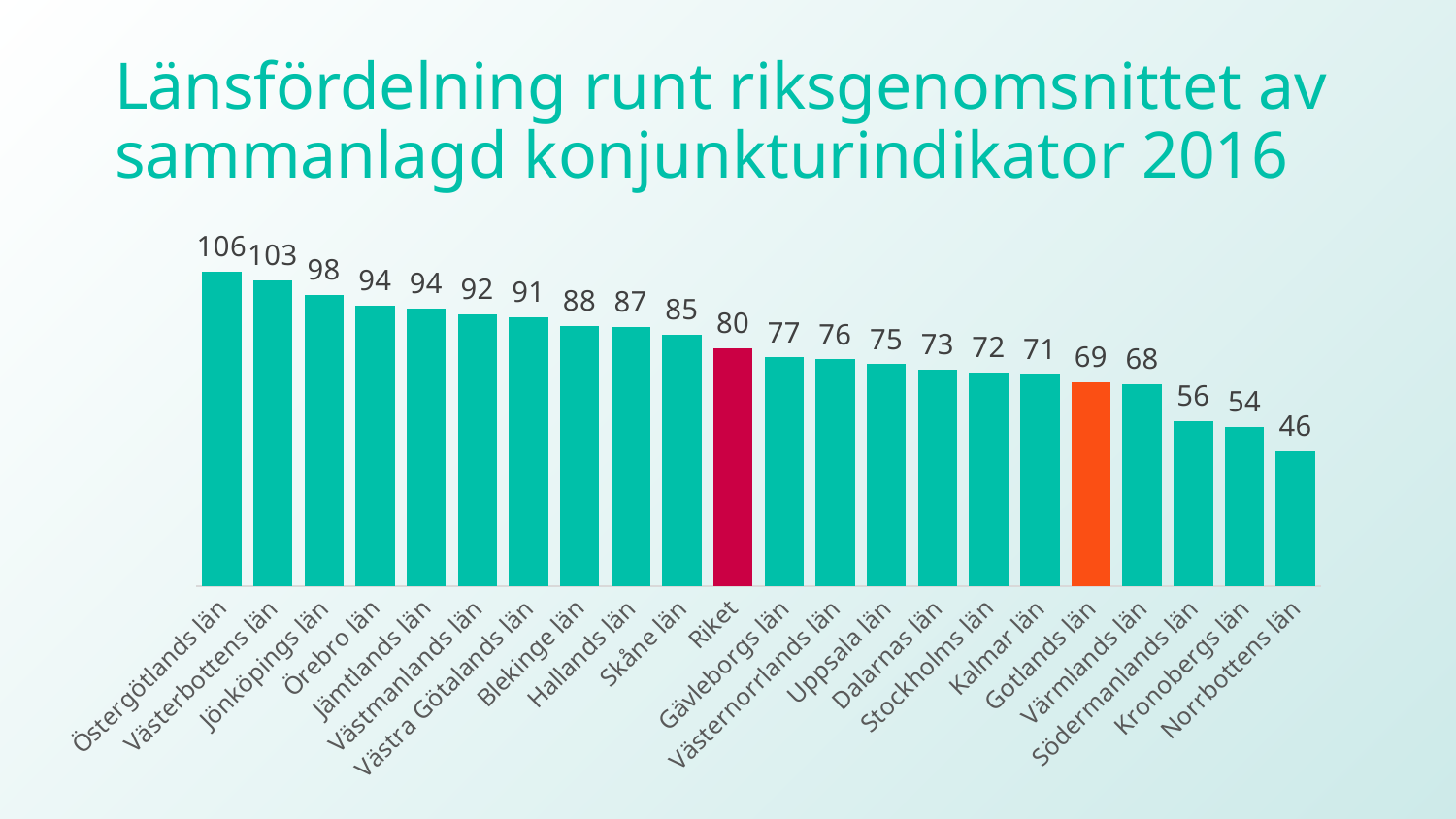
What is the difference between the values for Östergötlands län and Norrbottens län? 60 Do the values rise or fall from left to right along the x axis? Fall Which is larger, the value for Uppsala län or the value for Kalmar län? Uppsala län Which bar is coloured orange? Gotlands län What is the value for Riket? 80 What is the value for Stockholms län? 72 How many bars are shown in the chart? 22 What is the value for Gotlands län? 69 What is the difference between the values for Skåne län and Riket? 5 Which category has the lowest value? Norrbottens län What kind of chart is shown on the slide? Bar chart Which category has the highest value? Östergötlands län